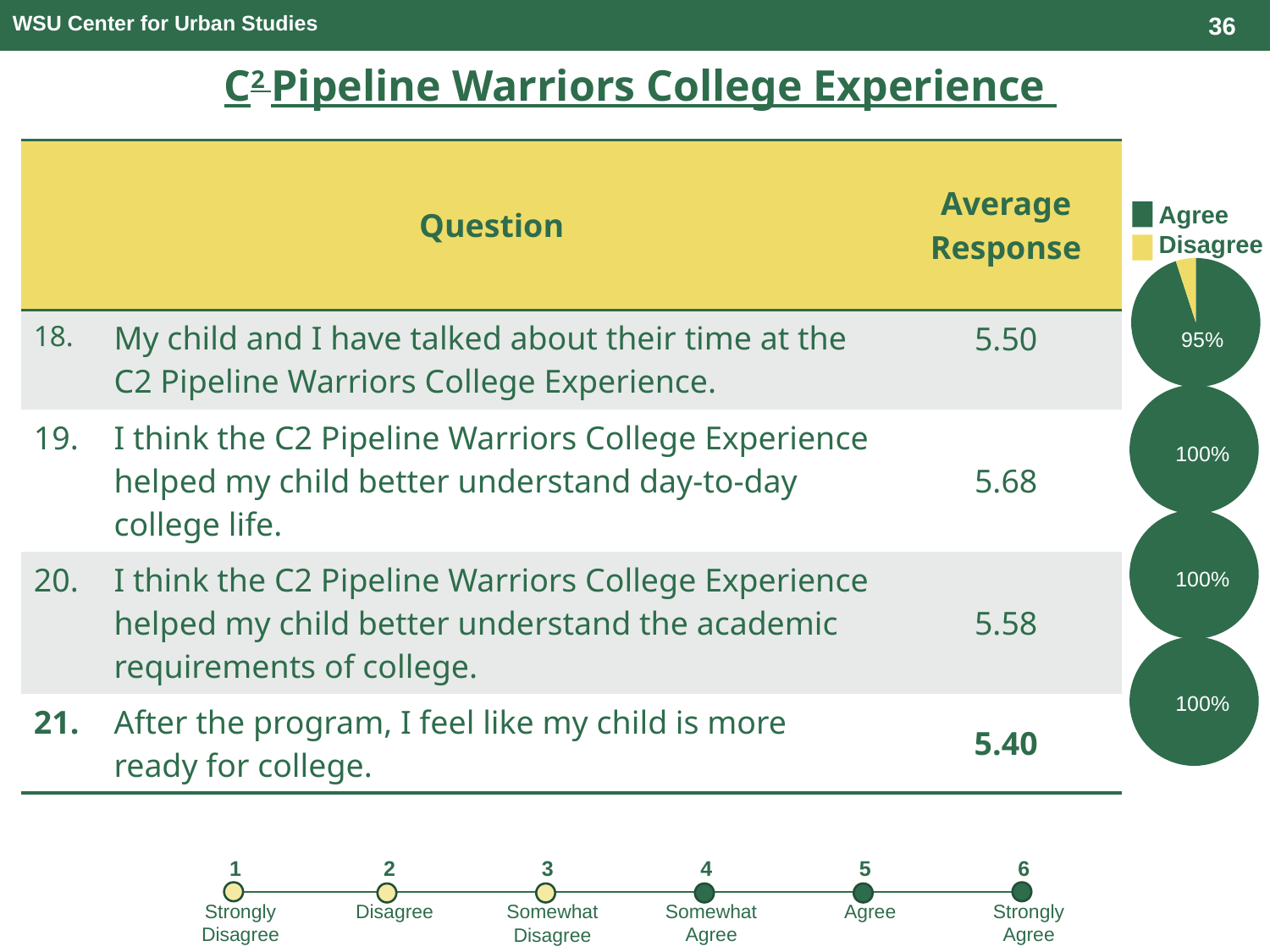
In the bottom pie chart (next to question 21), what percentage is shown? 100% How many entries does the legend for the pie charts list? 2 What colour represents Disagree in the pie chart legend? Yellow What kind of charts are shown on the right side of the slide? Pie charts In the top pie chart (next to question 18), what share of the pie is labelled? 95% In the top pie chart, which slice is larger, Agree or Disagree? Agree Which pie chart shows the lowest Agree percentage? The top pie chart (question 18) In the second pie chart from the top (next to question 19), what percentage is shown? 100% In the third pie chart from the top (next to question 20), what percentage is shown? 100% What colour represents Agree in the pie chart legend? Green In the top pie chart, what share of the pie is Disagree? 5% How many pie charts are on the slide? 4